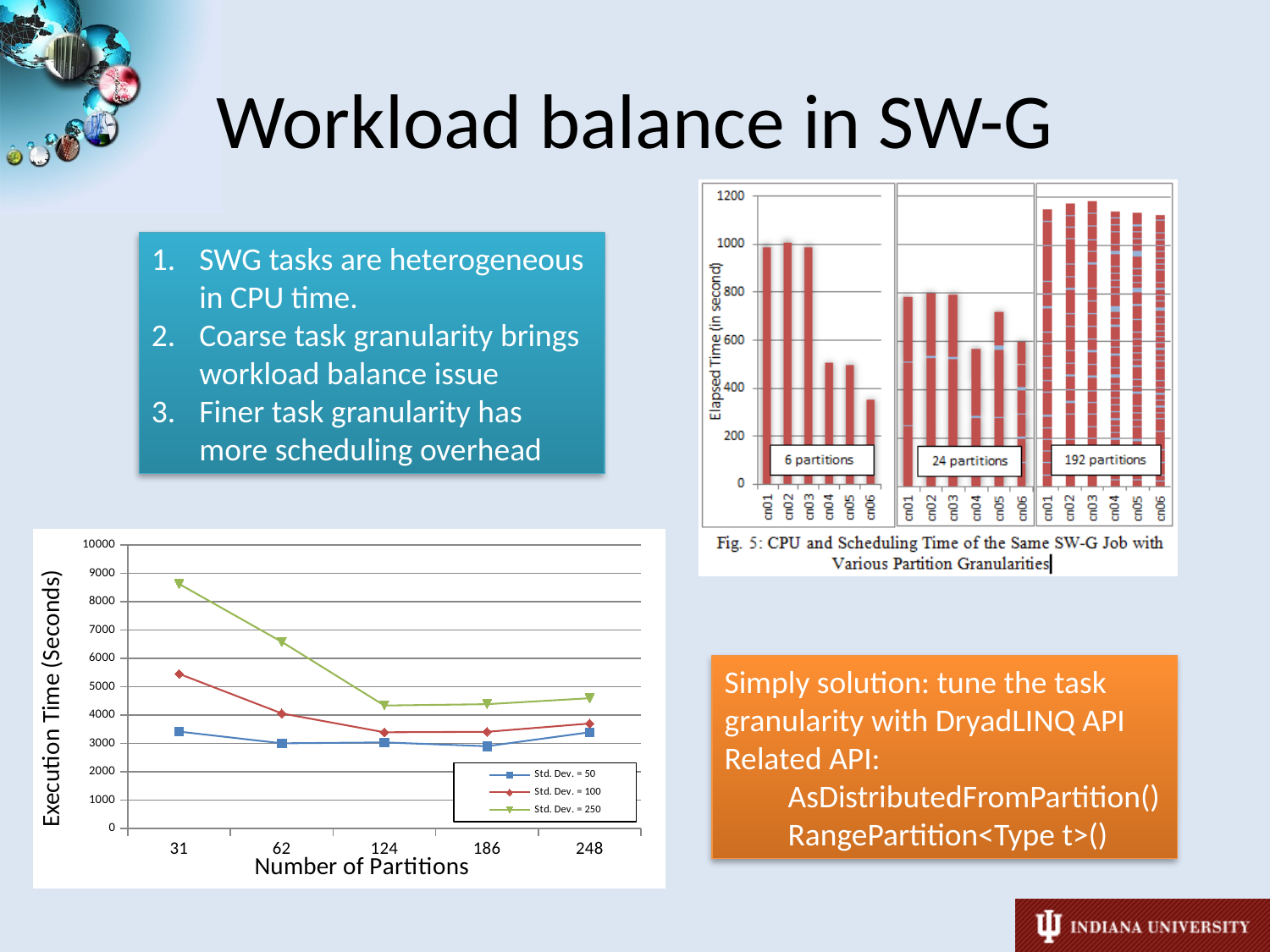
What is the y-axis label of the Fig. 5 bar chart? Elapsed Time (in second) In Fig. 5, which node has the lowest elapsed time in the 6 partitions panel? cn06 How many Number of Partitions values are plotted along the x axis of the bottom-left line chart? 5 In the bottom-left line chart, is the execution time for Std. Dev. = 250 at 31 partitions greater or less than 8000? greater In the bottom-left line chart, does the execution time for Std. Dev. = 250 rise or fall from 31 to 124 partitions? fall What kind of chart is the bottom-left chart of Execution Time versus Number of Partitions? line chart How many series does the legend of the bottom-left line chart list? 3 In the bottom-left line chart, which series has the highest execution time at 31 partitions? Std. Dev. = 250 In the bottom-left line chart, at 62 partitions, which is larger: the execution time for Std. Dev. = 100 or for Std. Dev. = 50? Std. Dev. = 100 In the bottom-left line chart, is the execution time for Std. Dev. = 50 at 62 partitions greater or less than 4000? less What kind of chart is Fig. 5 on the right of the slide? bar chart In Fig. 5, is the elapsed time for cn03 in the 192 partitions panel greater or less than 1000? greater